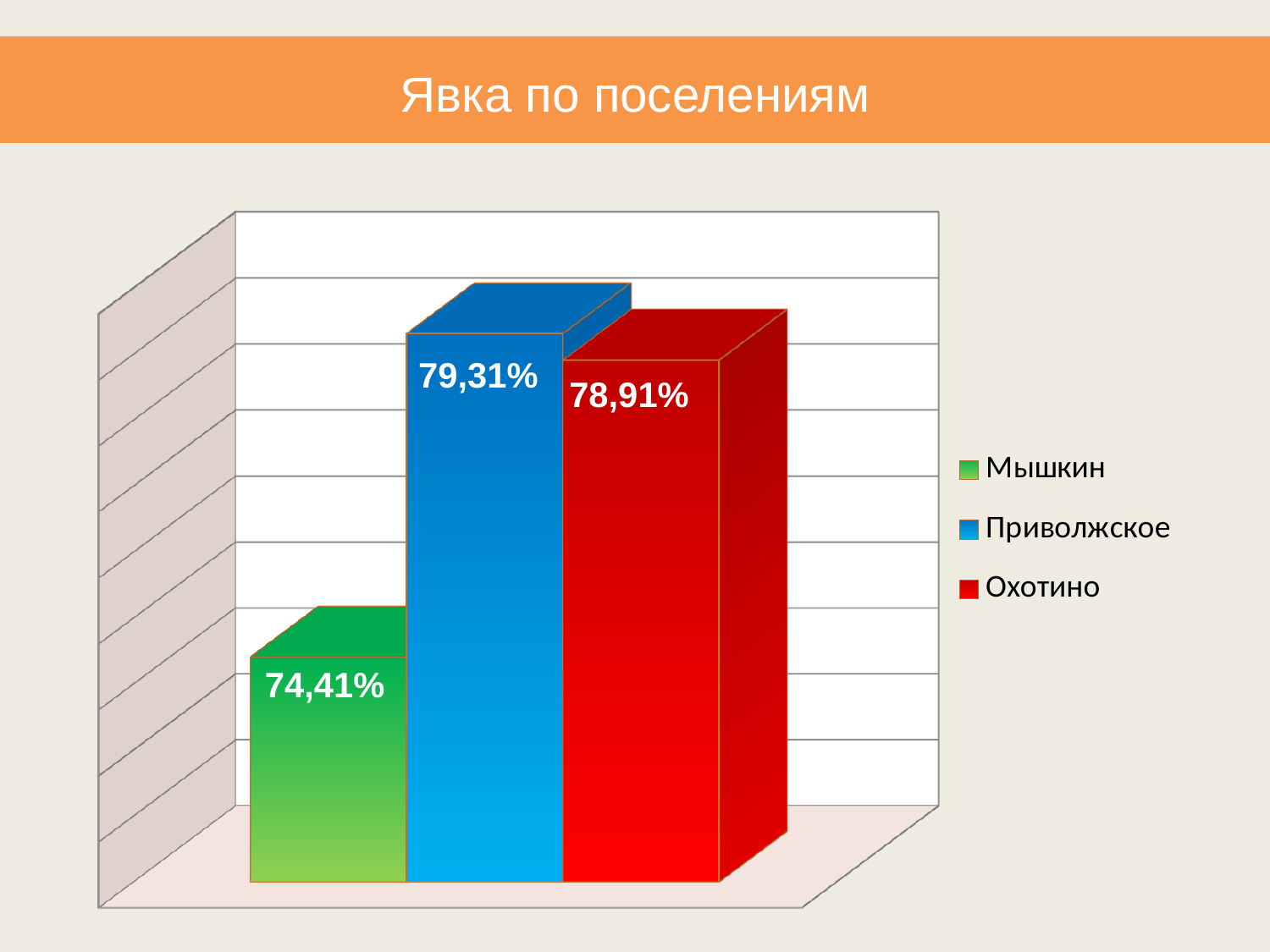
Which settlement has the lowest turnout on the chart? Мышкин What is the difference between the turnout for Охотино and the turnout for Мышкин? 4,50% Which settlement has the highest turnout on the chart? Приволжское How many bars are plotted on the chart? 3 What is the turnout value shown for Мышкин? 74,41% What is the title of the slide? Явка по поселениям What is the turnout value shown for Охотино? 78,91% Which is larger, the turnout for Охотино or the turnout for Мышкин? Охотино What is the turnout value shown for Приволжское? 79,31% How many entries does the legend list? 3 What kind of chart is shown on the slide? Bar chart What is the difference between the turnout for Приволжское and the turnout for Мышкин? 4,90%